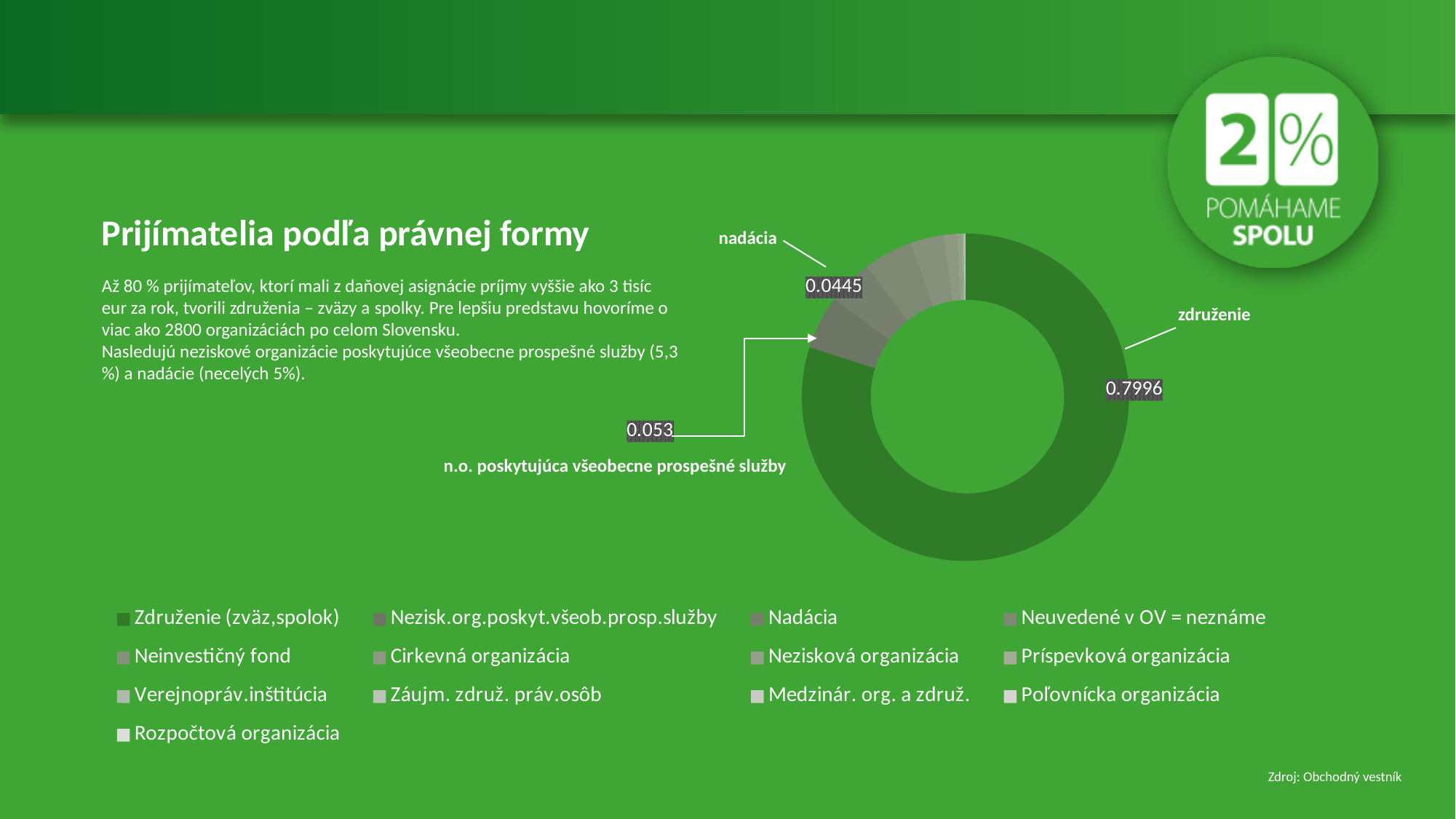
What is the value shown for nadácia in the doughnut chart? 0.0445 Which is larger, the value for nadácia or the value for n.o. poskytujúca všeobecne prospešné služby? n.o. poskytujúca všeobecne prospešné služby What is the first legend entry of the chart? Združenie (zväz,spolok) What is the value shown for n.o. poskytujúca všeobecne prospešné služby in the doughnut chart? 0.053 How many categories does the legend of the chart list? 13 What is the difference between the values for n.o. poskytujúca všeobecne prospešné služby and nadácia? 0.0085 What is the value shown for združenie in the doughnut chart? 0.7996 What kind of chart is shown on the slide? doughnut chart What is the difference between the values for združenie and n.o. poskytujúca všeobecne prospešné služby? 0.7466 What is the title of the chart on the slide? Prijímatelia podľa právnej formy Which category has the largest share in the doughnut chart? združenie